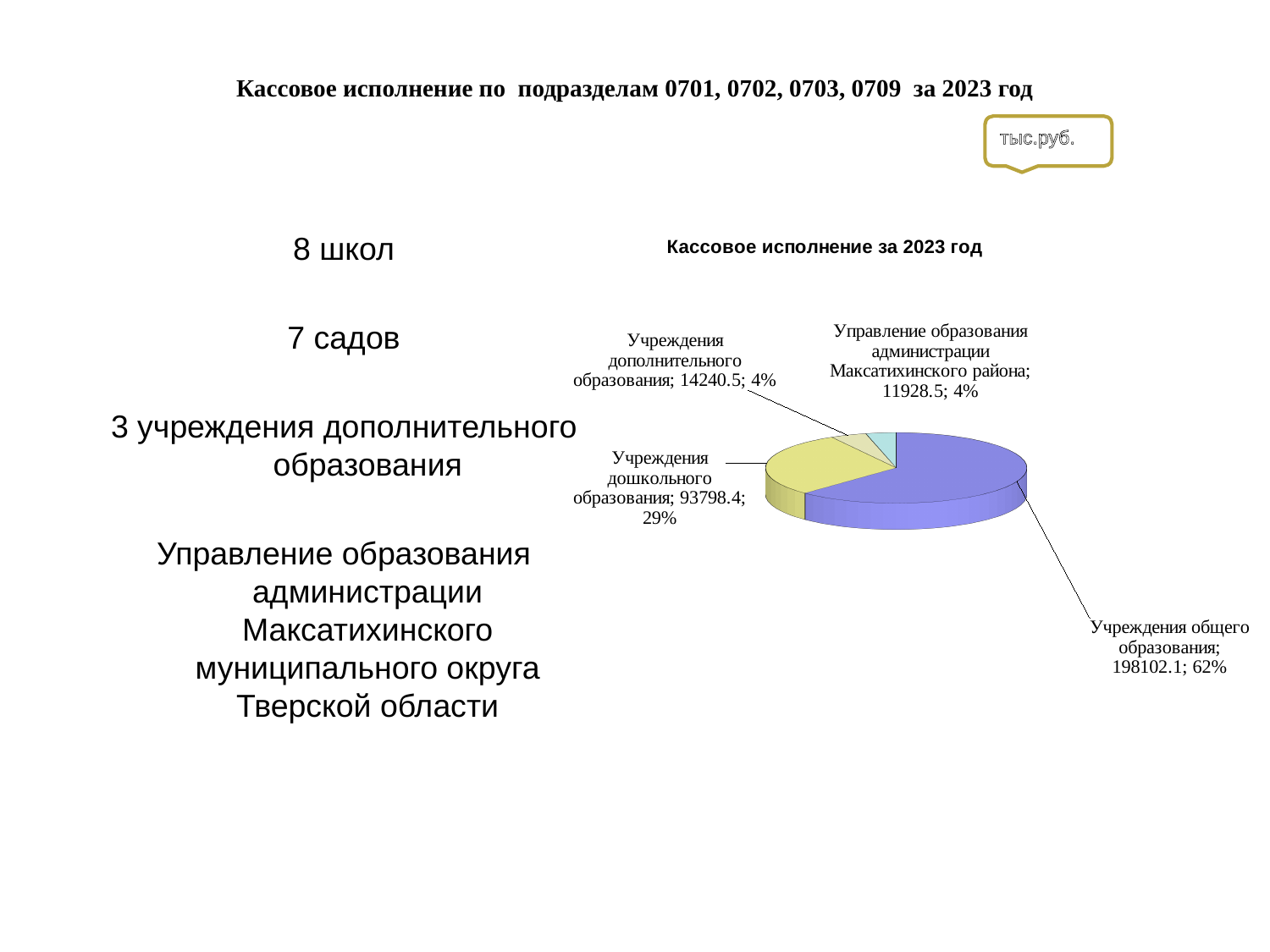
What is the value for Управление образования администрации Максатихинского района? 11928.5 How many slices does the pie chart have? 4 Which category has the smallest value in the pie chart? Управление образования администрации Максатихинского района What share of the pie does Учреждения дошкольного образования represent? 29% Which category has the largest slice of the pie? Учреждения общего образования Which is larger: the value for Учреждения дополнительного образования or for Управление образования администрации Максатихинского района? Учреждения дополнительного образования What is the difference between the values for Учреждения общего образования and Учреждения дошкольного образования? 104303.7 What is the value for Учреждения дошкольного образования? 93798.4 What is the value for Учреждения дополнительного образования? 14240.5 What is the title of the chart? Кассовое исполнение за 2023 год What is the value for Учреждения общего образования? 198102.1 What type of chart is shown on the slide? Pie chart